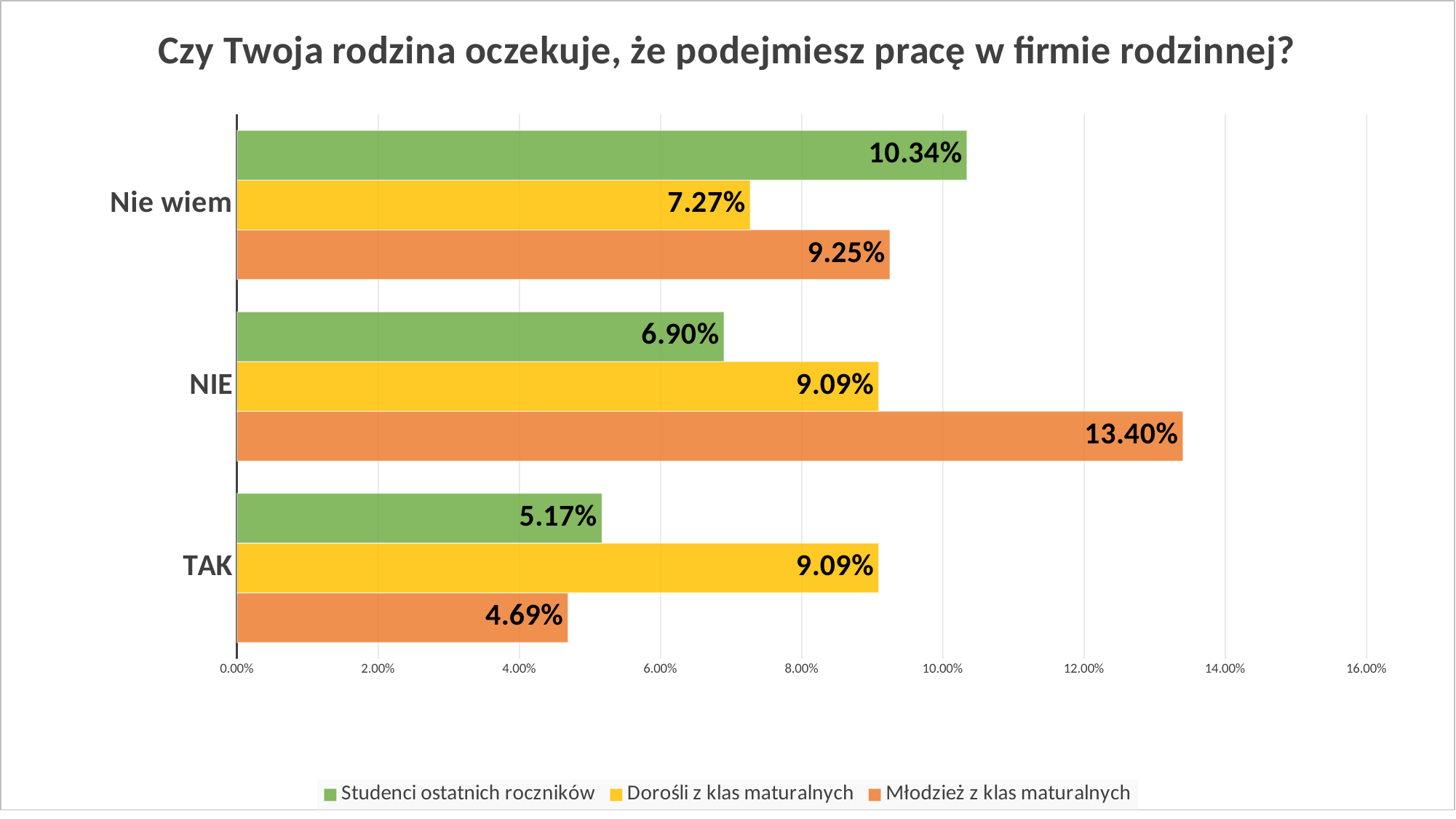
What is the value for Studenci ostatnich roczników in the Nie wiem category? 10.34% What is the difference between the Młodzież z klas maturalnych value for NIE and for TAK? 8.71% What kind of chart is shown on the slide? bar chart In the Nie wiem category, which is larger: Studenci ostatnich roczników or Dorośli z klas maturalnych? Studenci ostatnich roczników How many series does the legend list? 3 Is the value for Młodzież z klas maturalnych in the NIE category greater or less than 12.00%? greater What is the value for Młodzież z klas maturalnych in the NIE category? 13.40% Which category has the highest value for Młodzież z klas maturalnych? NIE What is the value for Dorośli z klas maturalnych in the TAK category? 9.09% Which category has the lowest value for Studenci ostatnich roczników? TAK Which colour represents Dorośli z klas maturalnych in the legend? yellow How many categories are shown on the y axis? 3